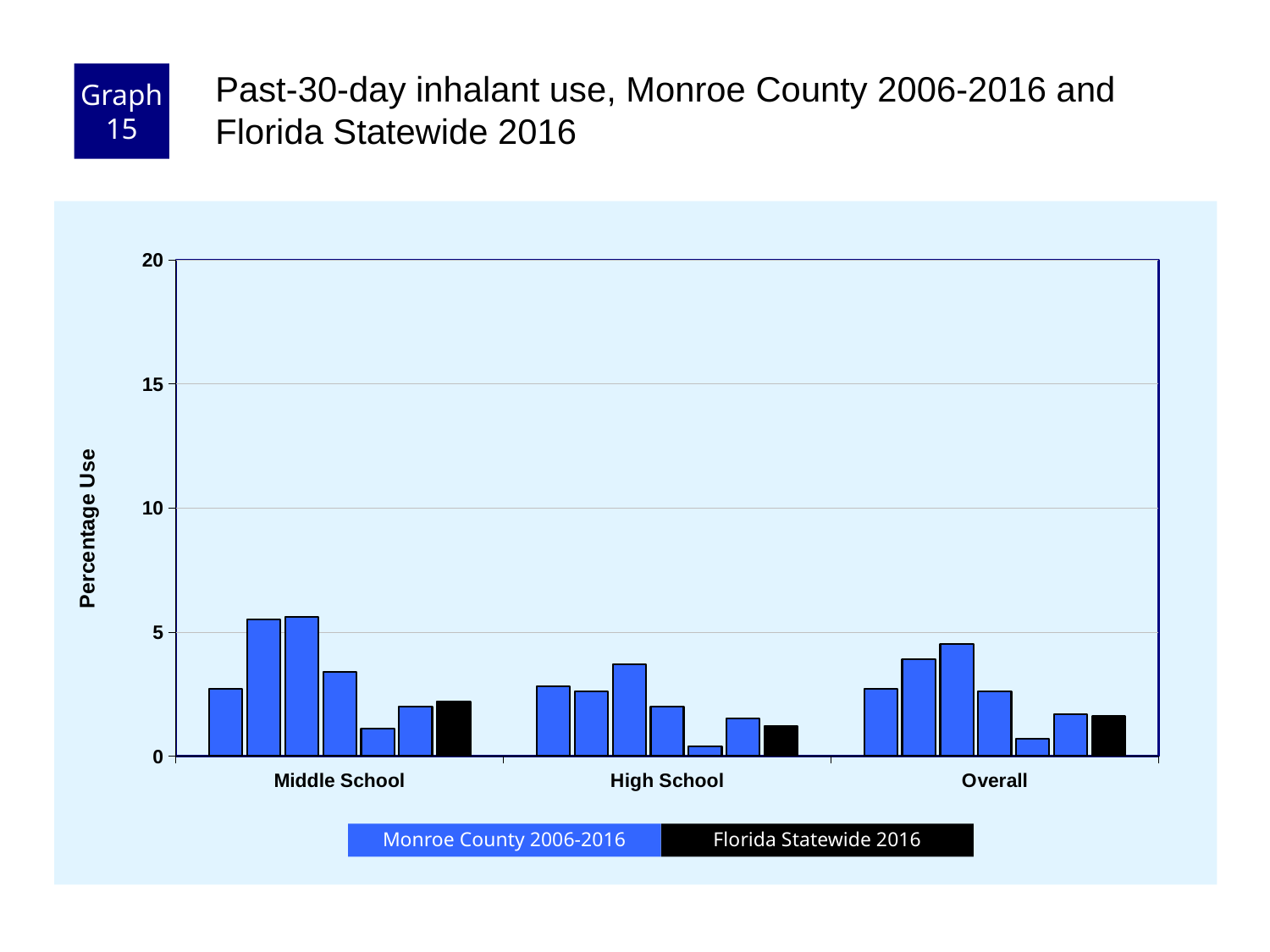
How many series does the legend list? 2 Which colour represents Florida Statewide 2016 in the legend? black Which category group contains the tallest bar on the chart? Middle School Is the Florida Statewide 2016 value for Middle School greater or less than 5? less Is the Florida Statewide 2016 value for High School greater or less than 5? less Is the Florida Statewide 2016 value for Overall greater or less than 5? less What kind of chart is shown on the slide? bar chart What is the title of the y axis? Percentage Use Which category group contains the shortest bar on the chart? High School How many school-level categories are shown on the x axis? 3 Which is larger, the Florida Statewide 2016 value for Middle School or for High School? Middle School